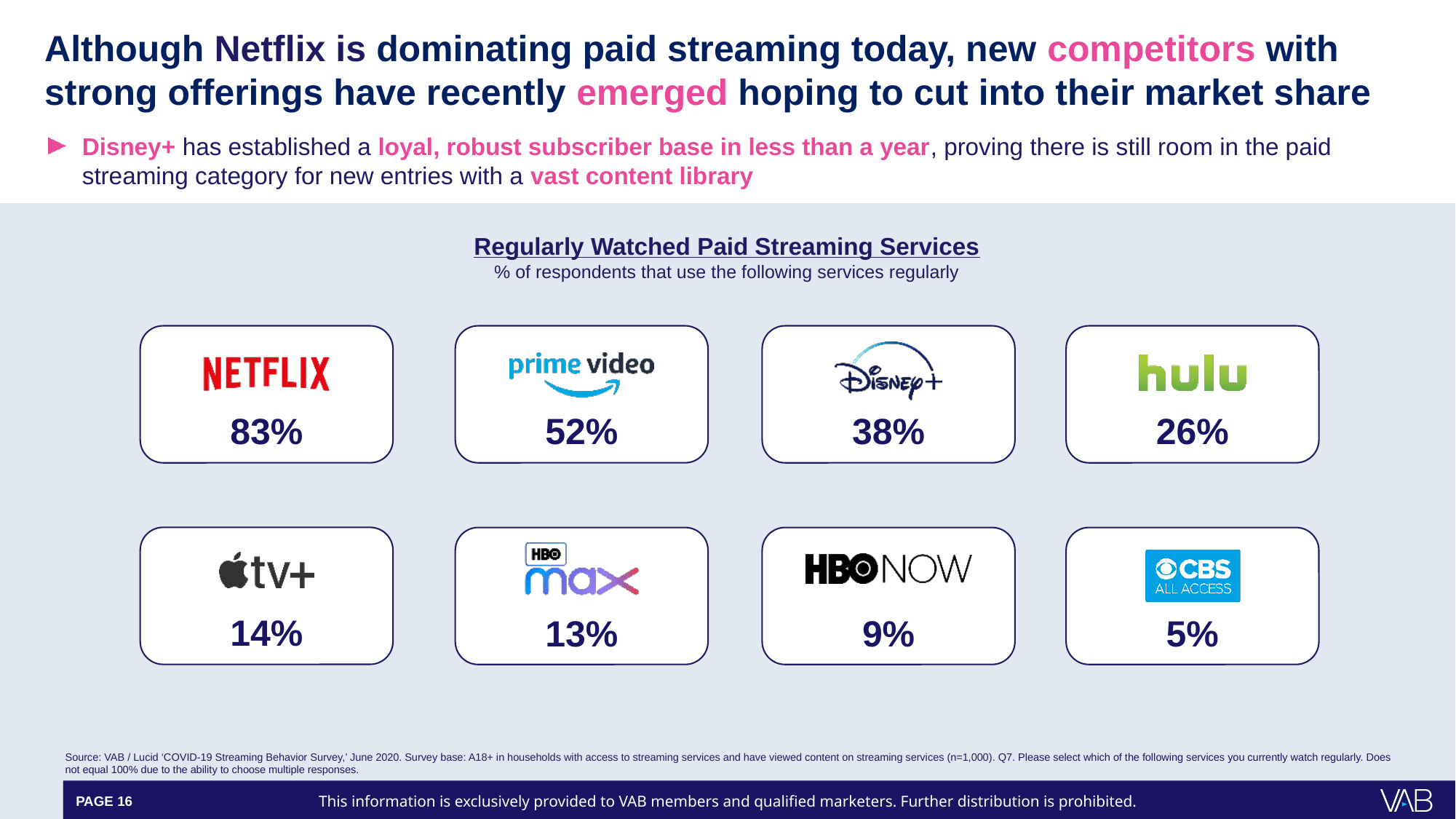
Which has a higher share of regular viewers, Disney+ or Hulu? Disney+ What percentage of respondents regularly watch Prime Video? 52% What percentage of respondents regularly watch Hulu? 26% How many paid streaming services are shown in the Regularly Watched Paid Streaming Services display? 8 Which paid streaming service has the lowest share of respondents watching it regularly? CBS All Access What percentage of respondents regularly watch Netflix? 83% Which paid streaming service has the highest share of respondents watching it regularly? Netflix What percentage of respondents regularly watch CBS All Access? 5% What is the difference in percentage points between Netflix and Prime Video? 31 What is the title of the data display on the slide? Regularly Watched Paid Streaming Services What is the difference in percentage points between Apple TV+ and HBO Max? 1 What percentage of respondents regularly watch Disney+? 38%